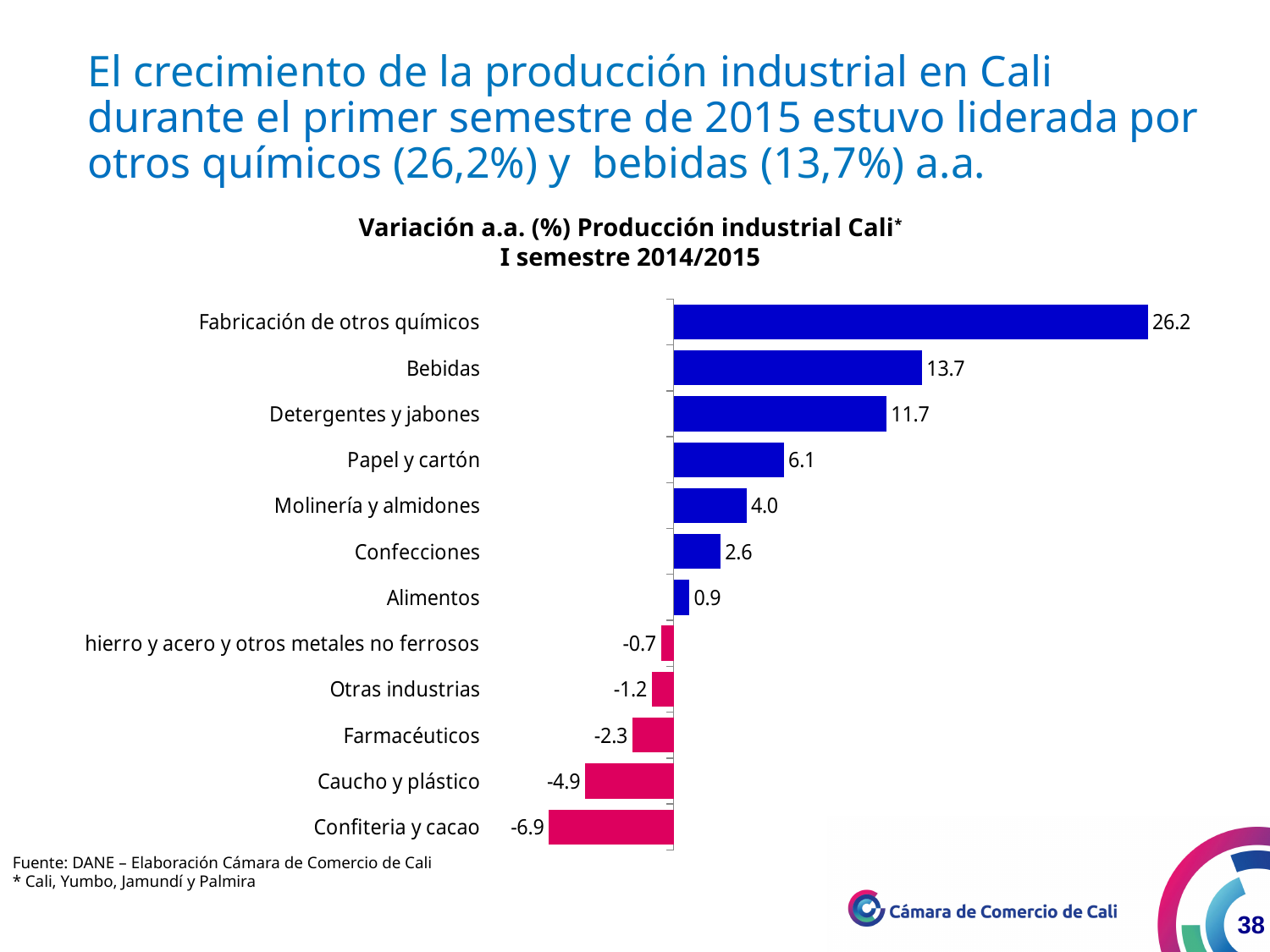
What is the value for Caucho y plástico? -4.9 What is the title of the chart? Variación a.a. (%) Producción industrial Cali* I semestre 2014/2015 What is the value for Bebidas? 13.7 Which is larger, the value for Molinería y almidones or the value for Confecciones? Molinería y almidones What is the difference between the values for Fabricación de otros químicos and Bebidas? 12.5 How many categories have a negative value? 5 What is the value for Papel y cartón? 6.1 What kind of chart is shown on the slide? Bar chart Which category has the lowest value? Confiteria y cacao What is the difference between the values for Detergentes y jabones and Papel y cartón? 5.6 How many categories are shown in the chart? 12 Which category has the highest value? Fabricación de otros químicos